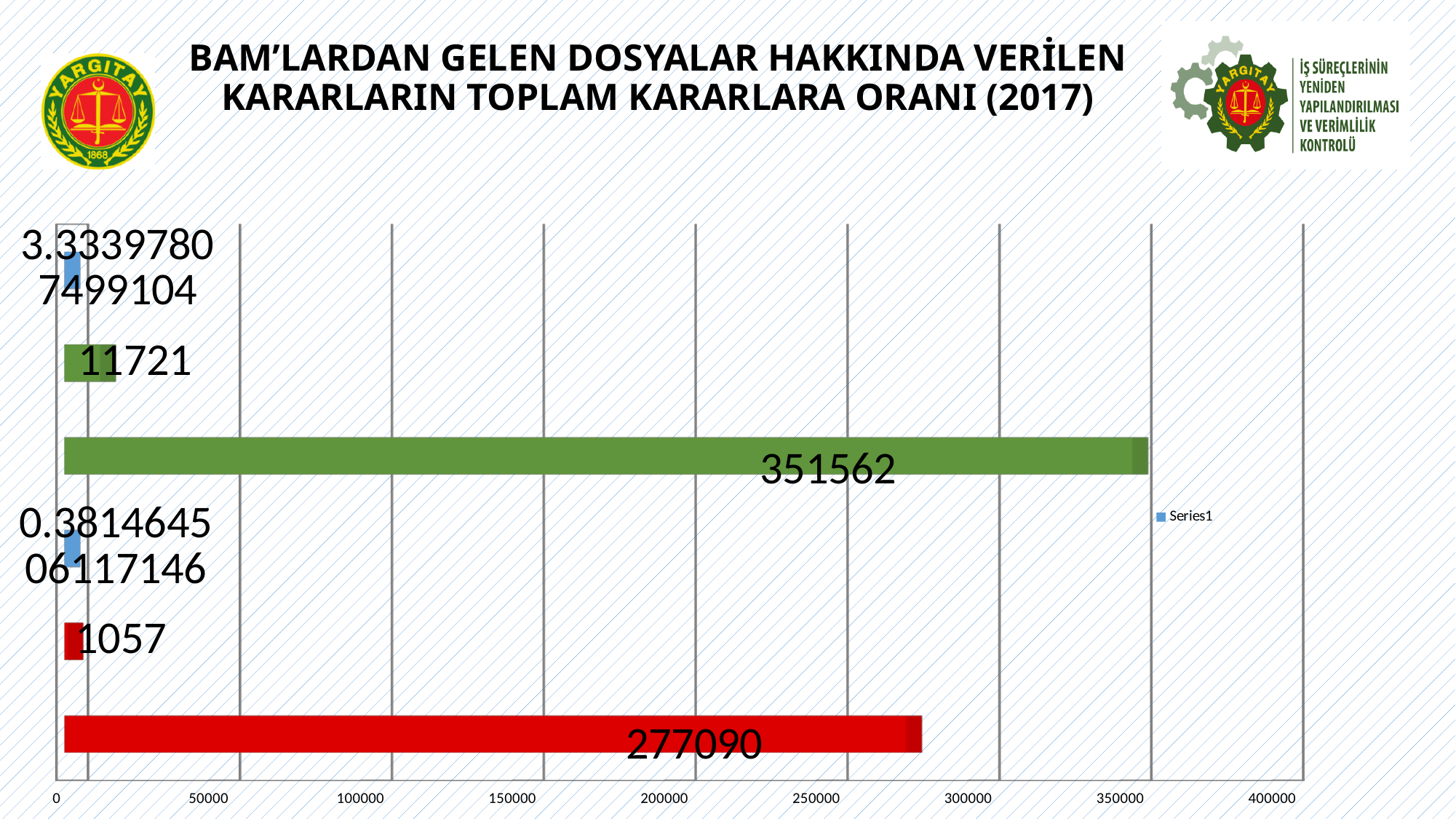
Which is larger, the longest green bar or the longest red bar? the longest green bar What is the title of the chart on the slide? BAM'LARDAN GELEN DOSYALAR HAKKINDA VERİLEN KARARLARIN TOPLAM KARARLARA ORANI (2017) What kind of chart is shown on the slide? bar chart How many series does the chart legend list? 1 What is the value shown on the short red bar? 1057 What is the value shown on the short green bar? 11721 What is the value shown on the longest green bar? 351562 What is the value shown on the longest red bar at the bottom of the chart? 277090 How many bars are plotted in the chart? 6 Is the value of the longest red bar greater or less than 250000? greater What is the highest value plotted in the chart? 351562 What is the difference between the longest green bar (351562) and the longest red bar (277090)? 74472